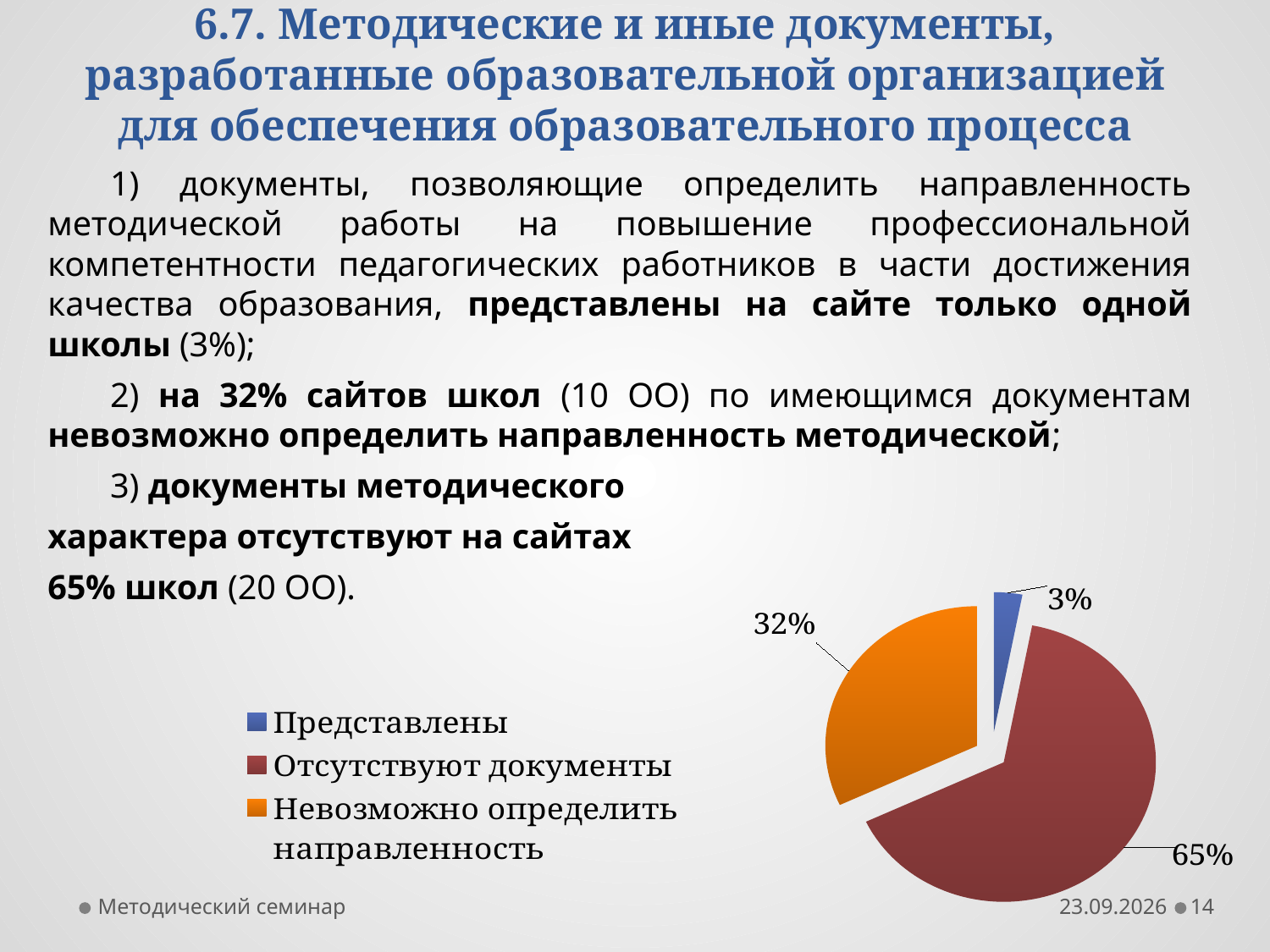
What share of the pie does the slice "Невозможно определить направленность" take? 32% What is the difference in percentage points between the "Отсутствуют документы" slice and the "Невозможно определить направленность" slice? 33 Which slice of the pie chart is the largest? Отсутствуют документы What colour is the "Представлены" slice in the pie chart? blue What kind of chart is shown on the slide? pie chart Which is larger: the "Невозможно определить направленность" slice or the "Представлены" slice? Невозможно определить направленность How many entries does the legend of the pie chart list? 3 How many slices does the pie chart have? 3 Which slice of the pie chart is the smallest? Представлены What colour is the "Отсутствуют документы" slice in the pie chart? dark red What share of the pie does the slice "Представлены" take? 3% What share of the pie does the slice "Отсутствуют документы" take? 65%